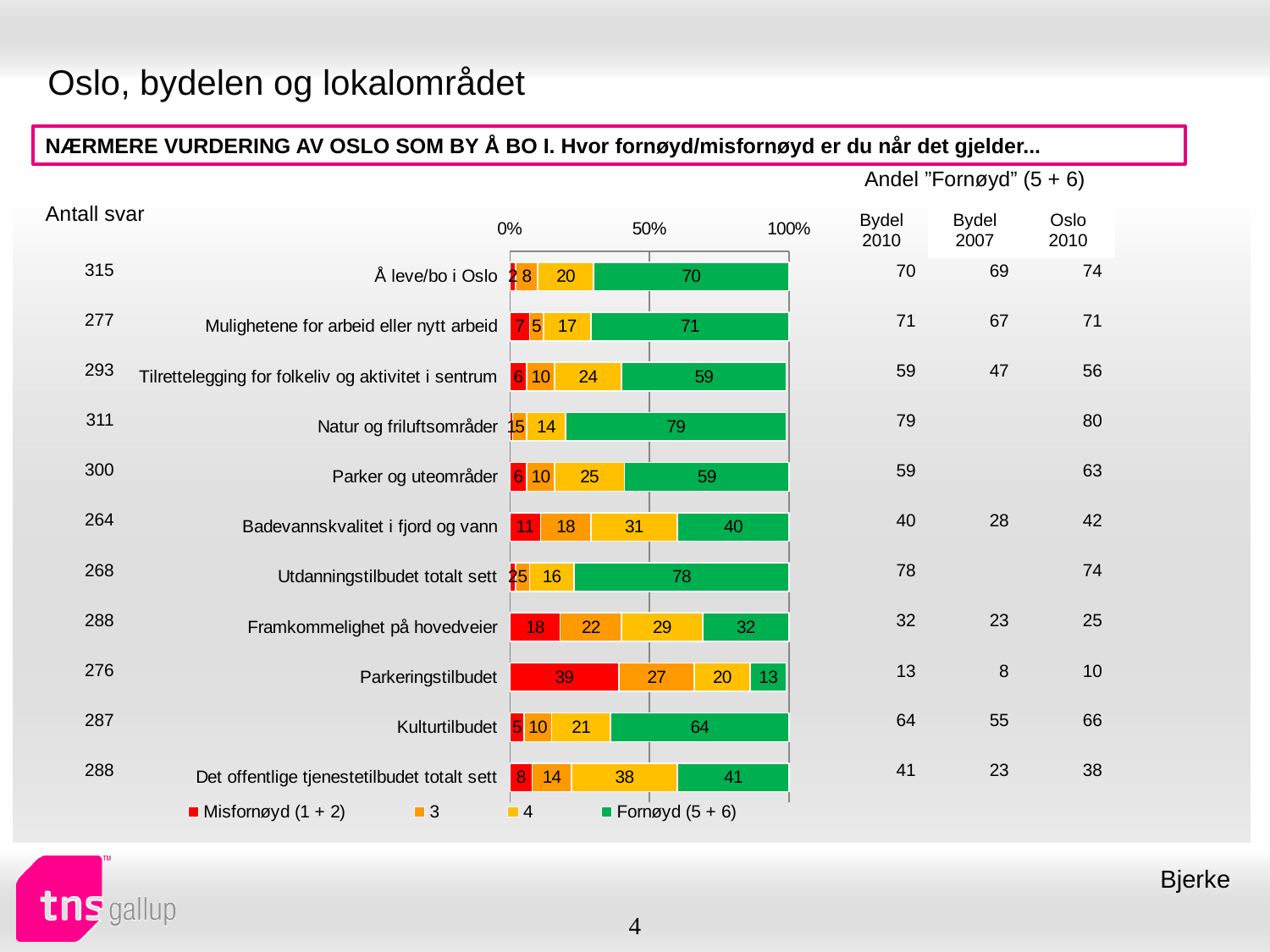
Which category has the lowest Fornøyd (5 + 6) value? Parkeringstilbudet What is the Fornøyd (5 + 6) value for Parkeringstilbudet? 13 What is the Misfornøyd (1 + 2) value for Framkommelighet på hovedveier? 18 How many series does the legend list? 4 What is the Misfornøyd (1 + 2) value for Parkeringstilbudet? 39 What is the difference between the Fornøyd (5 + 6) values for Natur og friluftsområder and Parkeringstilbudet? 66 Which has a larger Fornøyd (5 + 6) value, Kulturtilbudet or Badevannskvalitet i fjord og vann? Kulturtilbudet What colour represents Fornøyd (5 + 6) in the legend? Green What is the value of the '4' segment for Det offentlige tjenestetilbudet totalt sett? 38 Which category has the highest Fornøyd (5 + 6) value? Natur og friluftsområder How many categories are shown in the chart? 11 What kind of chart is shown on the slide? Stacked bar chart